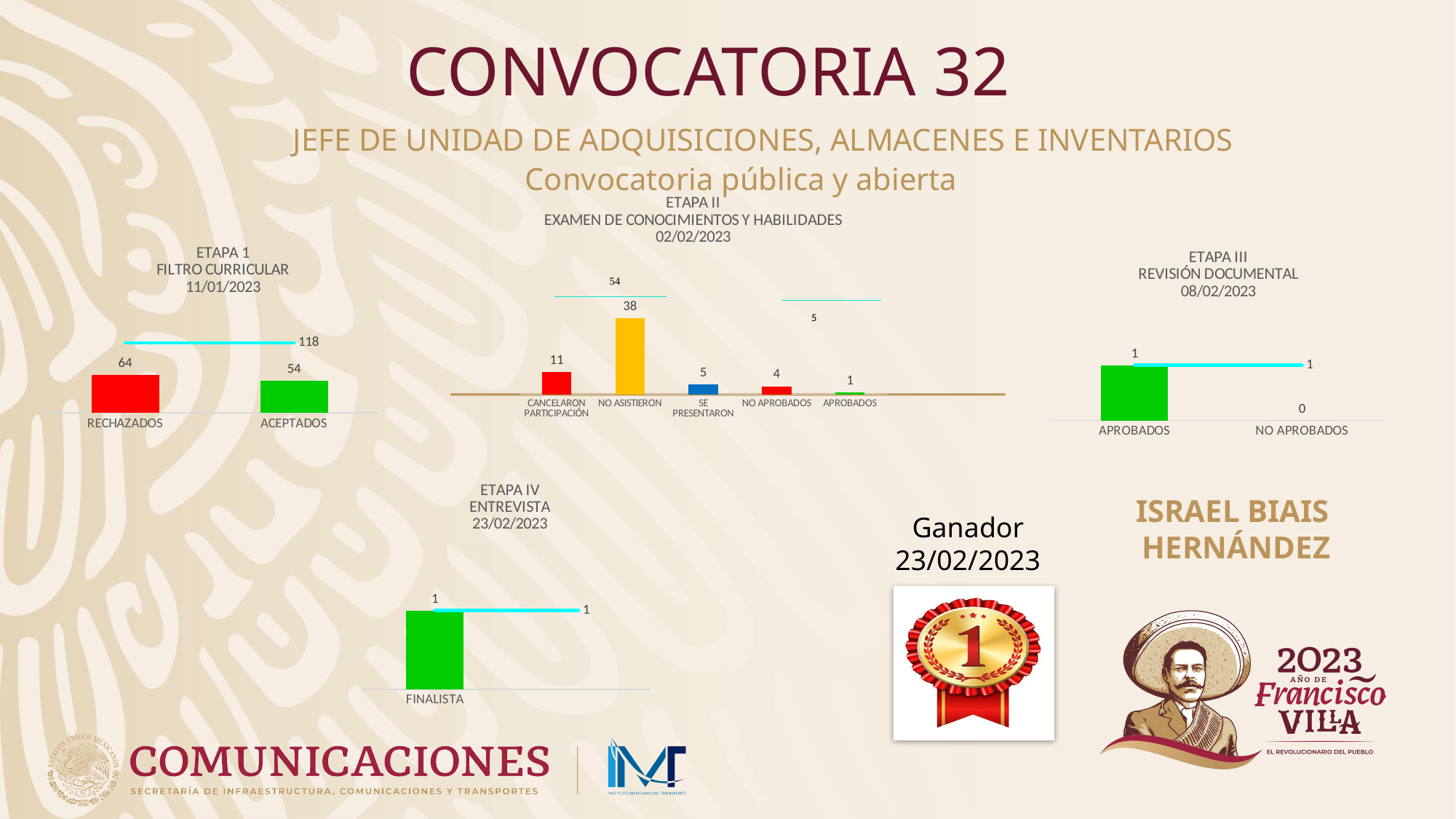
In the ETAPA IV ENTREVISTA chart, what is the value for FINALISTA? 1 In the ETAPA III REVISIÓN DOCUMENTAL chart, what is the value for NO APROBADOS? 0 In the ETAPA 1 FILTRO CURRICULAR chart, what is the value for RECHAZADOS? 64 In the ETAPA II EXAMEN DE CONOCIMIENTOS Y HABILIDADES chart, which category has the highest bar? NO ASISTIERON In the ETAPA 1 FILTRO CURRICULAR chart, what is the difference between RECHAZADOS and ACEPTADOS? 10 In the ETAPA 1 FILTRO CURRICULAR chart, what value is labelled on the horizontal line above the bars? 118 In the ETAPA II EXAMEN DE CONOCIMIENTOS Y HABILIDADES chart, which is larger: SE PRESENTARON or NO APROBADOS? SE PRESENTARON In the ETAPA 1 FILTRO CURRICULAR chart, what is the value for ACEPTADOS? 54 In the ETAPA II EXAMEN DE CONOCIMIENTOS Y HABILIDADES chart, how many categories are shown on the x axis? 5 In the ETAPA II EXAMEN DE CONOCIMIENTOS Y HABILIDADES chart, what is the value for CANCELARON PARTICIPACIÓN? 11 In the ETAPA II EXAMEN DE CONOCIMIENTOS Y HABILIDADES chart, which category has the lowest bar? APROBADOS What kind of chart is the ETAPA 1 FILTRO CURRICULAR chart? Combination bar and line chart